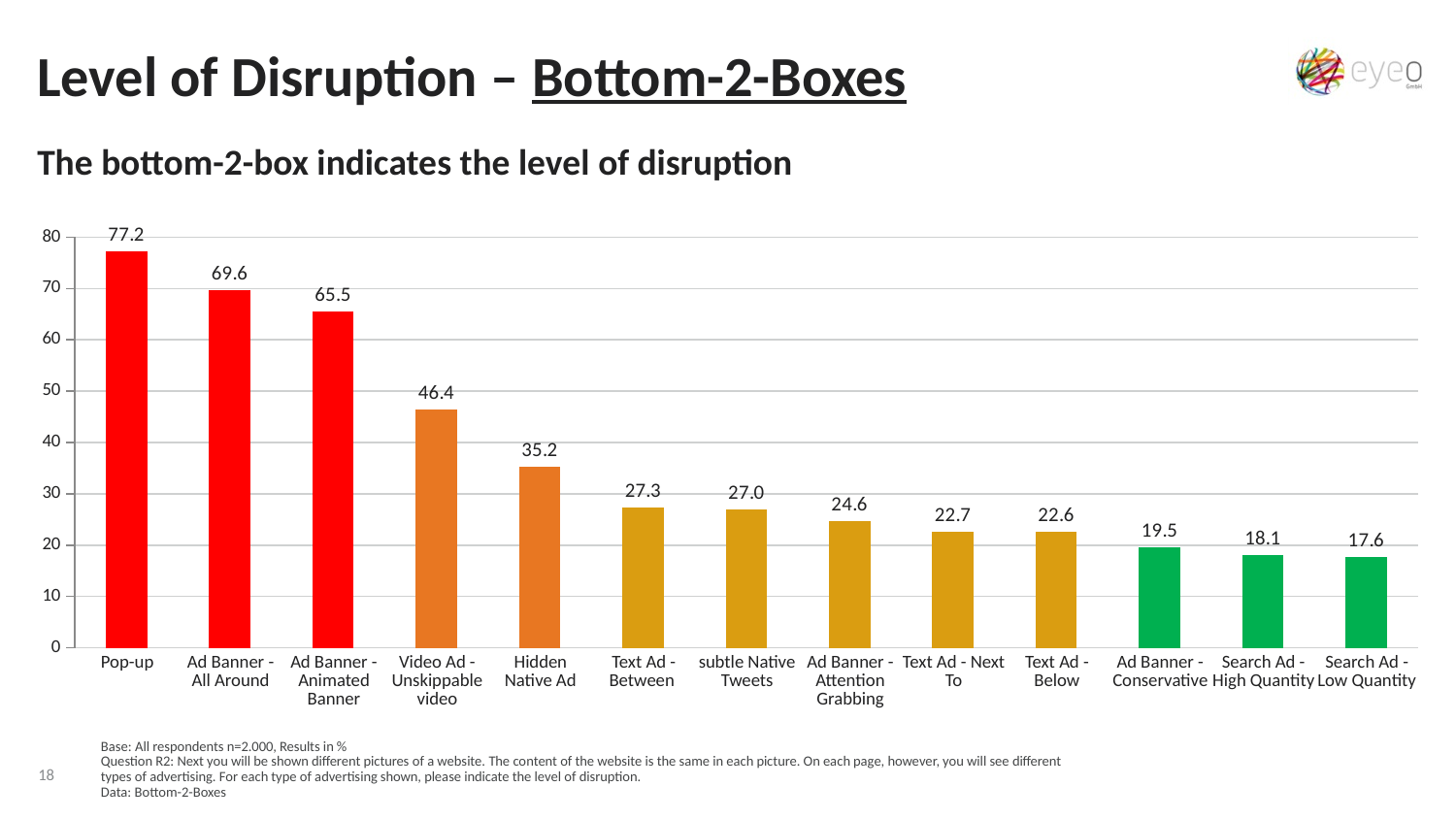
What is the difference between the values for Pop-up and Ad Banner - All Around? 7.6 What kind of chart is shown on the slide? bar chart How many categories are shown on the x axis? 13 Do the values rise or fall from left to right along the x axis? fall What is the value for Video Ad - Unskippable video? 46.4 What colour are the bars for the three Ad Banner categories on the left (Pop-up, All Around, Animated Banner)? red What is the value for Pop-up? 77.2 Which is larger, the value for Hidden Native Ad or the value for Text Ad - Between? Hidden Native Ad What is the value for Search Ad - Low Quantity? 17.6 Is the value for Ad Banner - Animated Banner greater or less than 60? greater Which category has the highest value? Pop-up Which category has the lowest value? Search Ad - Low Quantity